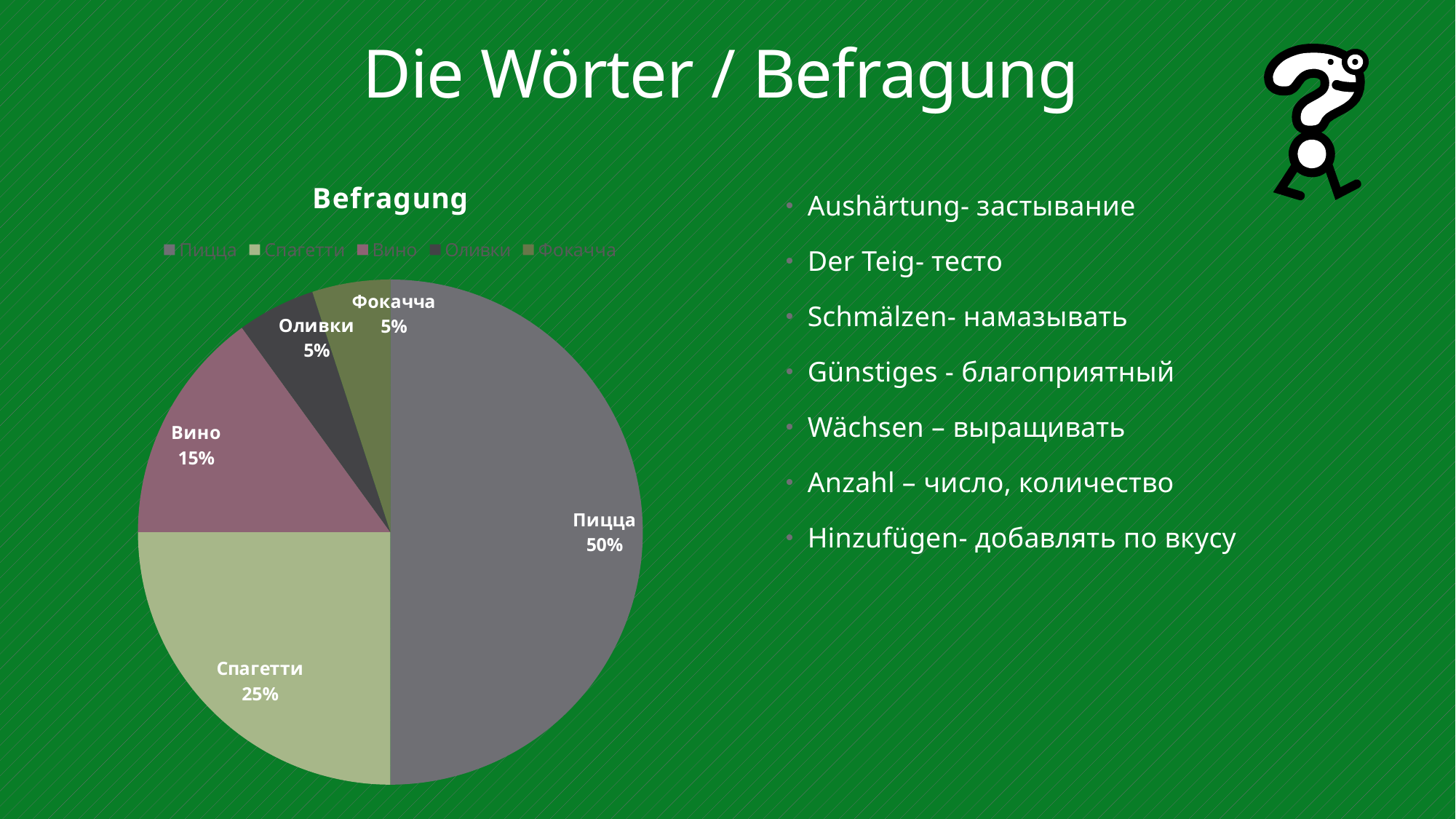
What share of the pie does Вино have? 15% What share of the pie does Спагетти have? 25% What is the title of the chart? Befragung How many entries does the legend list? 5 What share of the pie does Пицца have? 50% Which is larger, the share of Вино or the share of Фокачча? Вино What is the combined share of Оливки and Фокачча? 10% What kind of chart is shown on the slide? pie chart Which category has the largest slice of the pie? Пицца How many slices does the pie chart have? 5 What is the difference between the shares of Пицца and Спагетти? 25% What share of the pie does Оливки have? 5%